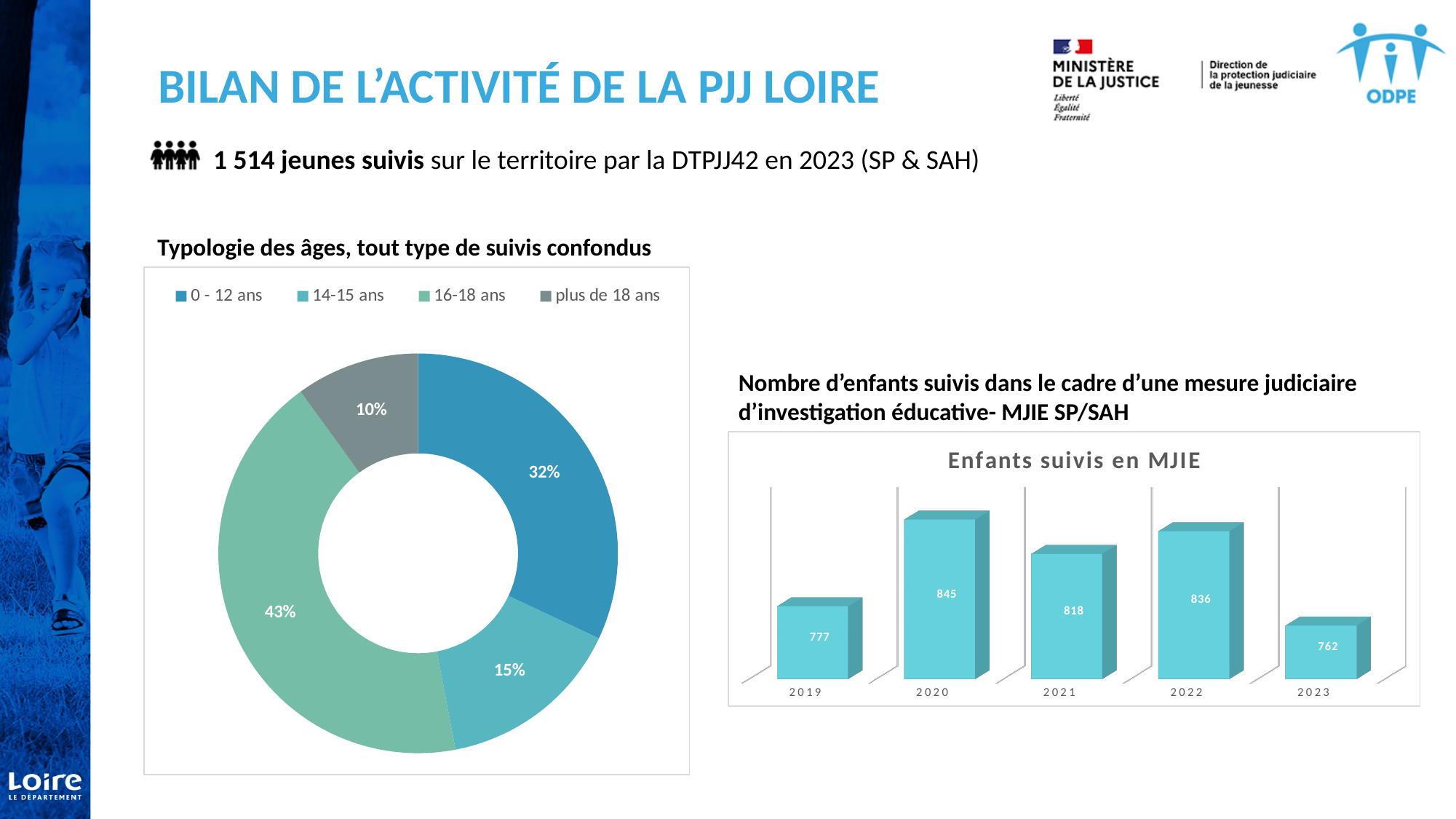
In the 'Enfants suivis en MJIE' chart, which year has the highest value? 2020 In the 'Typologie des âges' donut chart, which age category has the smallest share? plus de 18 ans In the 'Typologie des âges' donut chart, how many age categories does the legend list? 4 What kind of chart is 'Enfants suivis en MJIE'? bar chart In the 'Typologie des âges' donut chart, what share is shown for the 16-18 ans category? 43% In the 'Typologie des âges' donut chart, what share is shown for the 0 - 12 ans category? 32% In the 'Enfants suivis en MJIE' chart, which year has the lowest value? 2023 In the 'Enfants suivis en MJIE' chart, what is the value for 2023? 762 In the 'Enfants suivis en MJIE' chart, what is the value for 2020? 845 In the 'Typologie des âges' donut chart, which age category has the largest share? 16-18 ans In the 'Typologie des âges' donut chart, what is the difference in percentage points between the 14-15 ans and plus de 18 ans shares? 5 In the 'Enfants suivis en MJIE' chart, what is the difference between the values for 2022 and 2021? 18